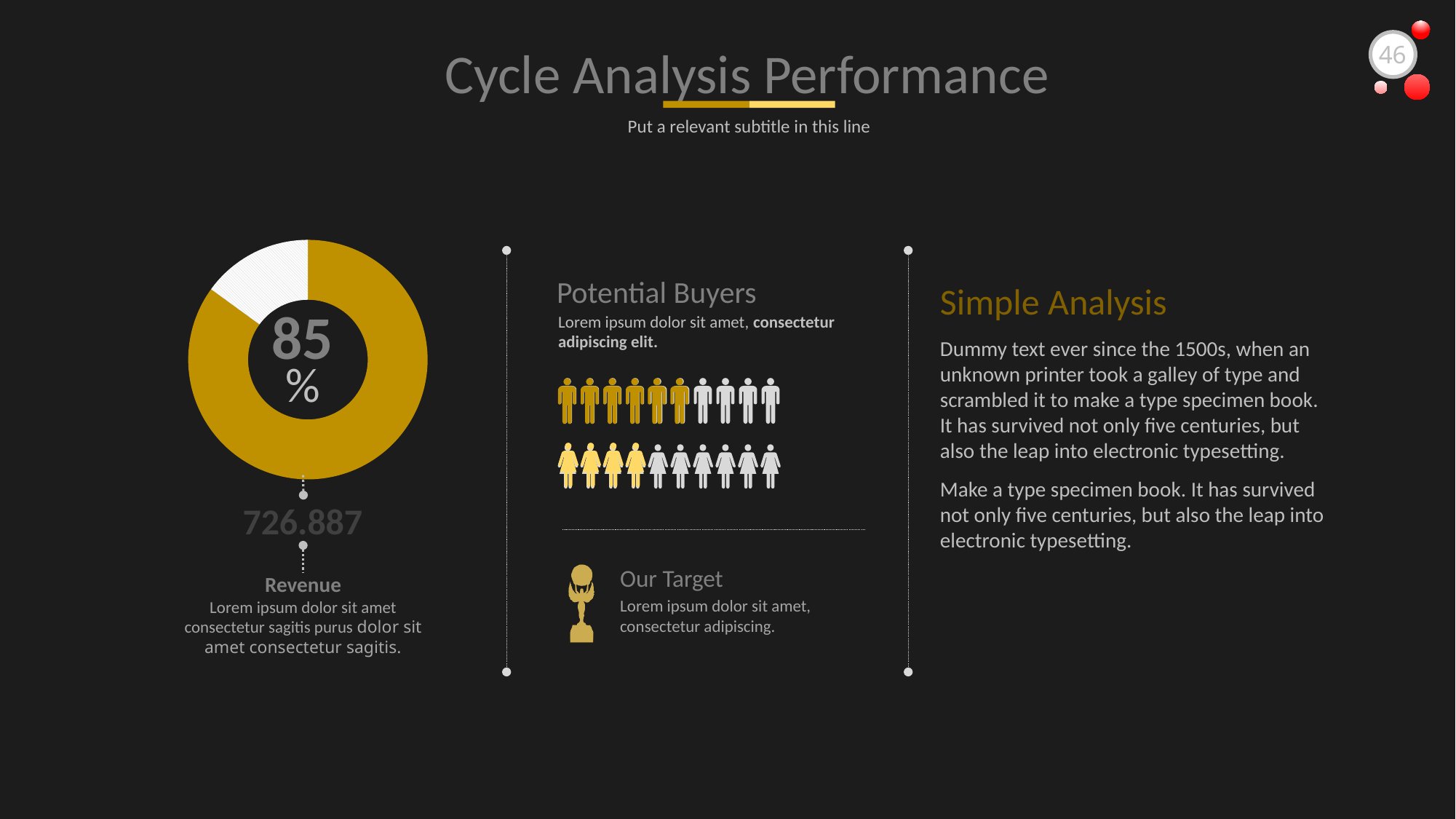
What percentage is printed in the centre of the donut chart? 85% What share of the donut chart does the gold portion represent? 85% What kind of chart is shown on the left of the slide? donut (pie) chart In the donut chart, which portion is larger, the gold portion or the white portion? gold How many person icons are there in total in the Potential Buyers pictogram? 20 How many person icons are in the top row of the Potential Buyers pictogram? 10 What label appears beneath the number 726.887 under the donut chart? Revenue What number is printed directly below the donut chart? 726.887 How many of the icons in the bottom row of the Potential Buyers pictogram are coloured gold? 4 What is the title of the slide containing the donut chart? Cycle Analysis Performance